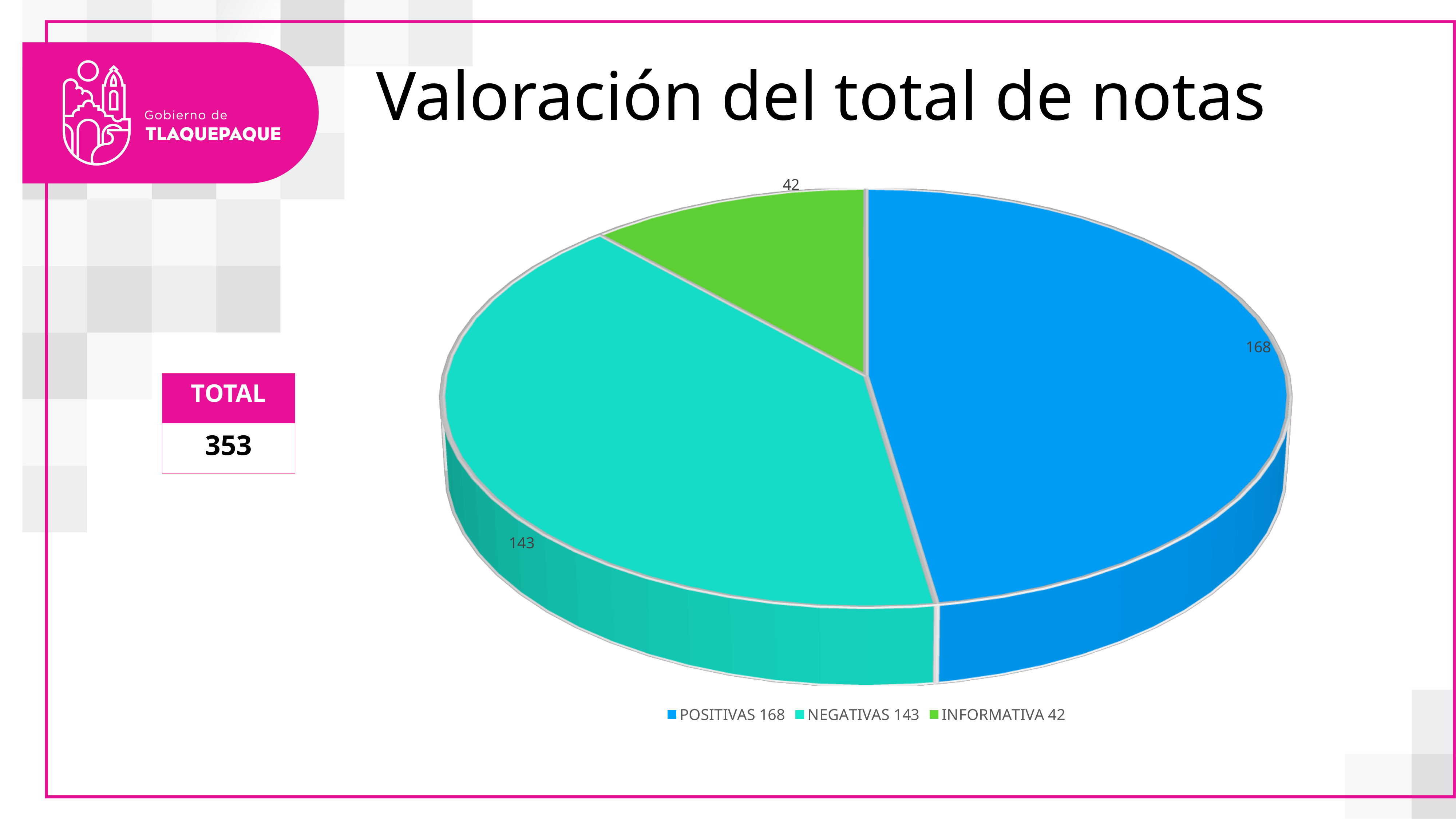
What is the title of the chart on the slide? Valoración del total de notas What kind of chart is shown on the slide? Pie chart How many categories does the pie chart have? 3 What is the value for POSITIVAS in the pie chart? 168 What total is shown in the TOTAL box on the slide? 353 Which is larger, the value for NEGATIVAS or the value for INFORMATIVA? NEGATIVAS What is the difference between the POSITIVAS and NEGATIVAS values? 25 What is the value for NEGATIVAS in the pie chart? 143 What is the difference between the NEGATIVAS and INFORMATIVA values? 101 Which category has the largest slice in the pie chart? POSITIVAS What is the value for INFORMATIVA in the pie chart? 42 Which category has the smallest slice in the pie chart? INFORMATIVA